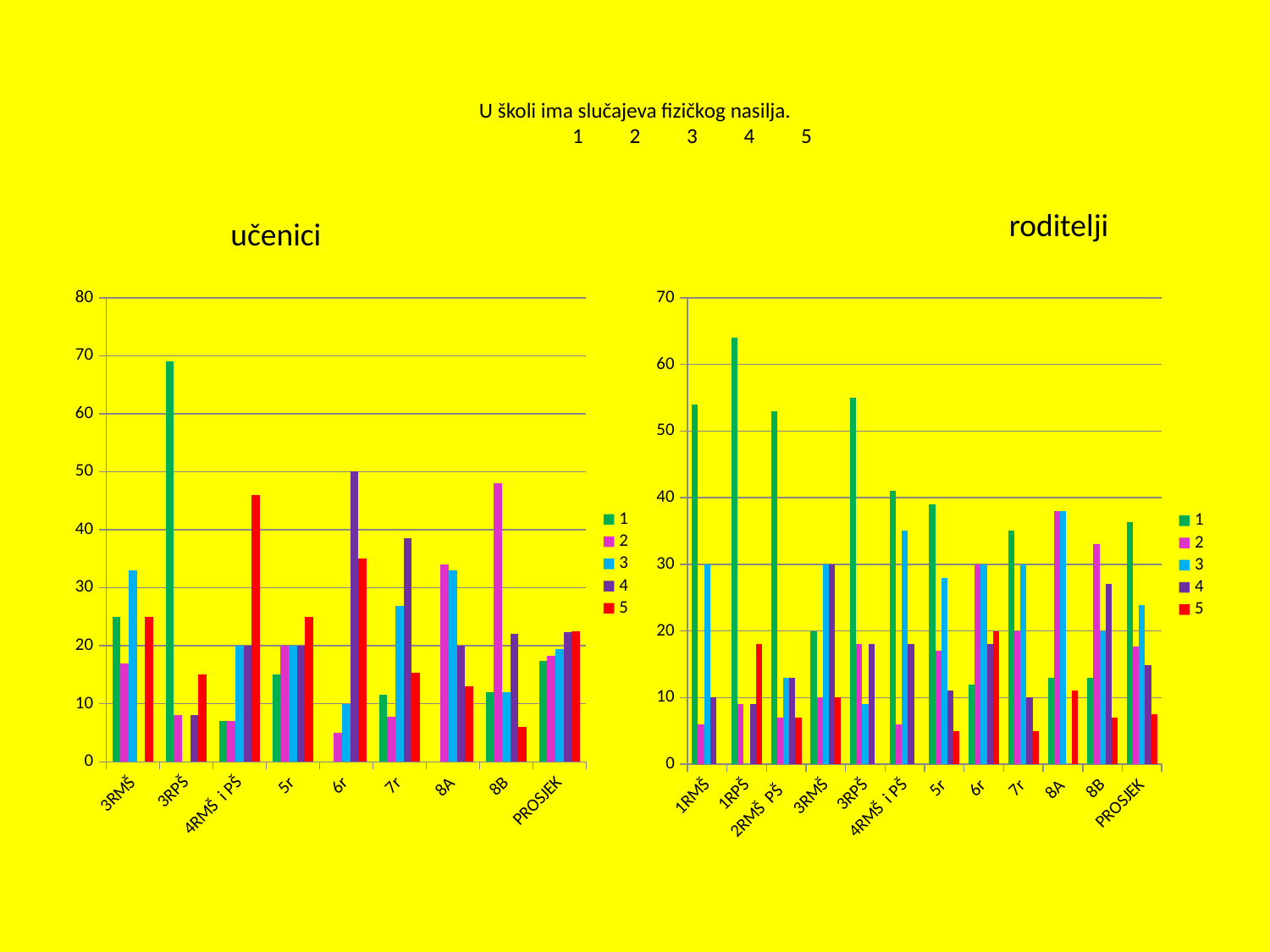
In the 'roditelji' chart, which category has the tallest bar for series 1? 1RPŠ In the 'roditelji' chart, is the value of series 5 for 8A greater or less than 20? less In the 'učenici' chart, which category has the tallest bar for series 1? 3RPŠ How many categories are shown on the x axis of the 'roditelji' chart? 12 What is the title of the chart on the right side of the slide? roditelji What kind of chart is the 'učenici' chart on the left? bar chart In the 'roditelji' chart, is the value of series 1 for 1RPŠ greater or less than 60? greater How many categories are shown on the x axis of the 'učenici' chart? 9 How many series does the legend of the 'roditelji' chart list? 5 In the 'učenici' chart, for category 6r, which is larger: series 4 or series 5? series 4 In the 'učenici' chart, is the value of series 2 for 8B greater or less than 40? greater